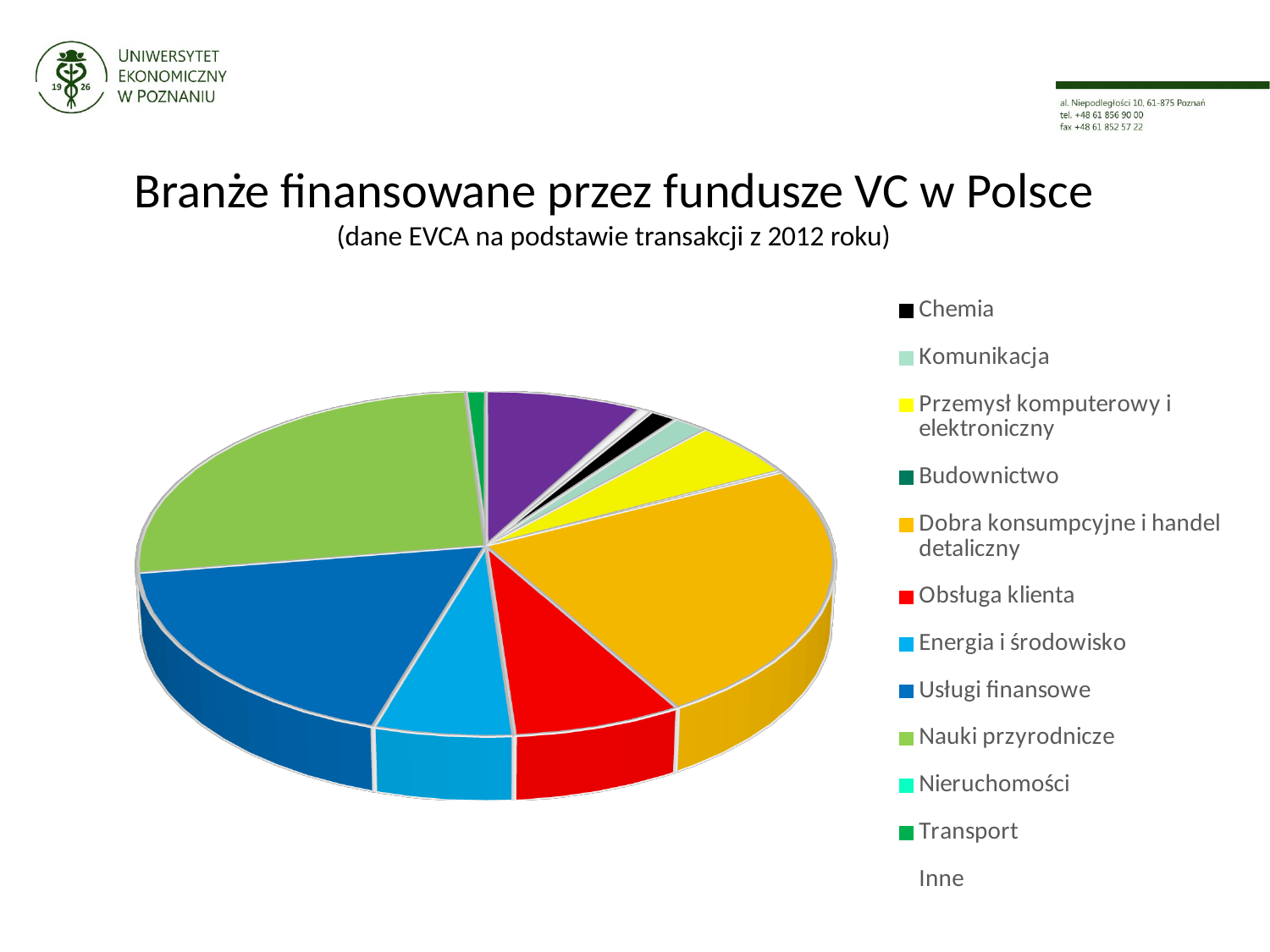
Which category has the largest slice of the pie? Nauki przyrodnicze Which slice is larger: Dobra konsumpcyjne i handel detaliczny or Przemysł komputerowy i elektroniczny? Dobra konsumpcyjne i handel detaliczny Which slice is larger: Nauki przyrodnicze or Energia i środowisko? Nauki przyrodnicze Which slice is larger: Obsługa klienta or Budownictwo? Obsługa klienta How many categories does the legend of the pie chart list? 12 What colour represents Obsługa klienta in the pie chart? red What is the title of the chart on the slide? Branże finansowane przez fundusze VC w Polsce What kind of chart is shown on the slide? pie chart